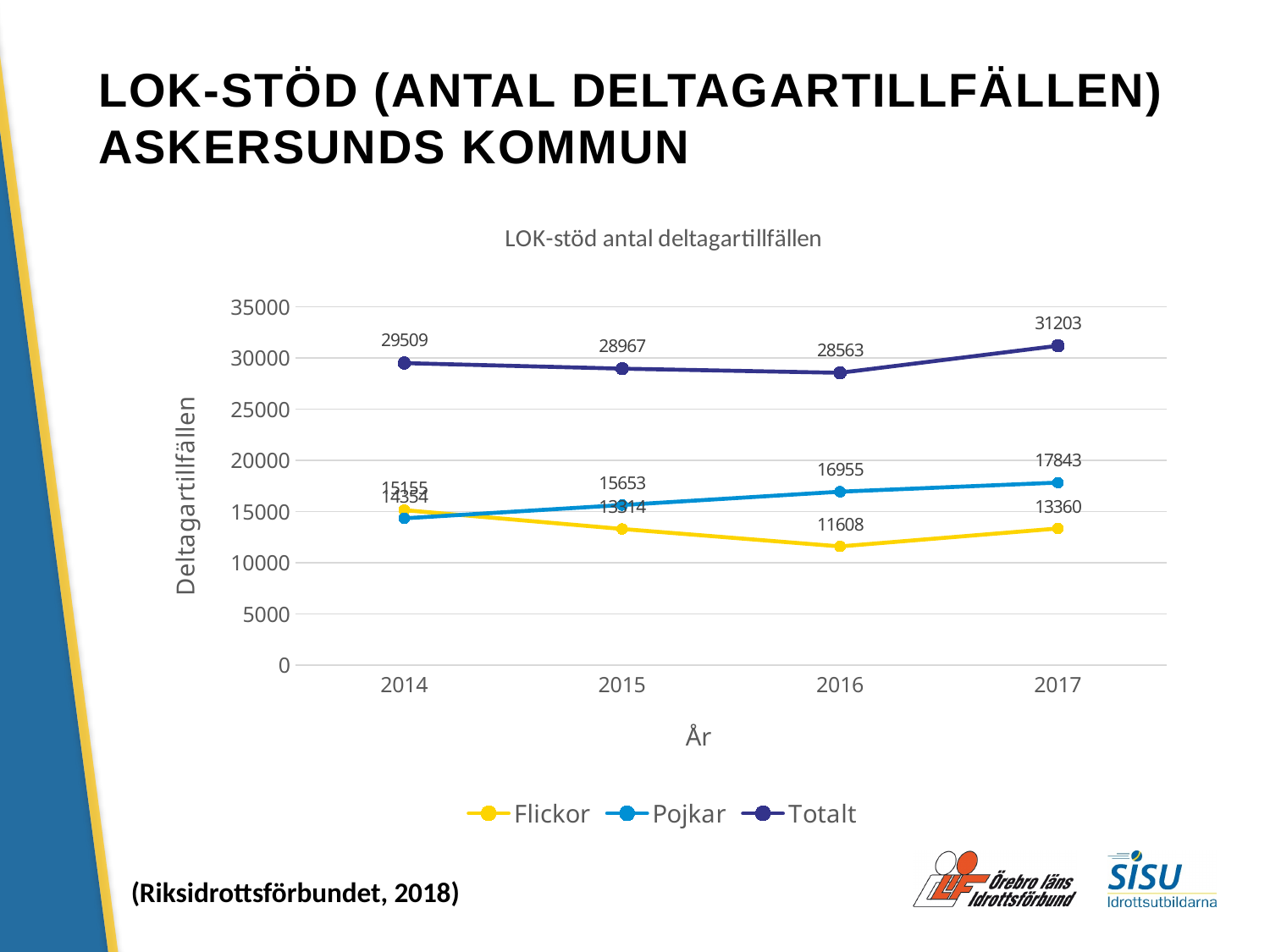
By how much did Totalt increase from 2016 to 2017? 2640 What is the difference between Pojkar in 2017 and Pojkar in 2016? 888 How many years are shown on the x axis? 4 In which year is the Totalt series highest? 2017 What kind of chart is shown on the slide? line chart Is the value for Totalt in 2016 greater or less than 30000? less What is the value for Flickor in 2016? 11608 How many series does the legend list? 3 In 2017, which series has the larger value, Pojkar or Flickor? Pojkar What is the value for Totalt in 2017? 31203 What is the value for Pojkar in 2016? 16955 In which year is the Flickor series lowest? 2016